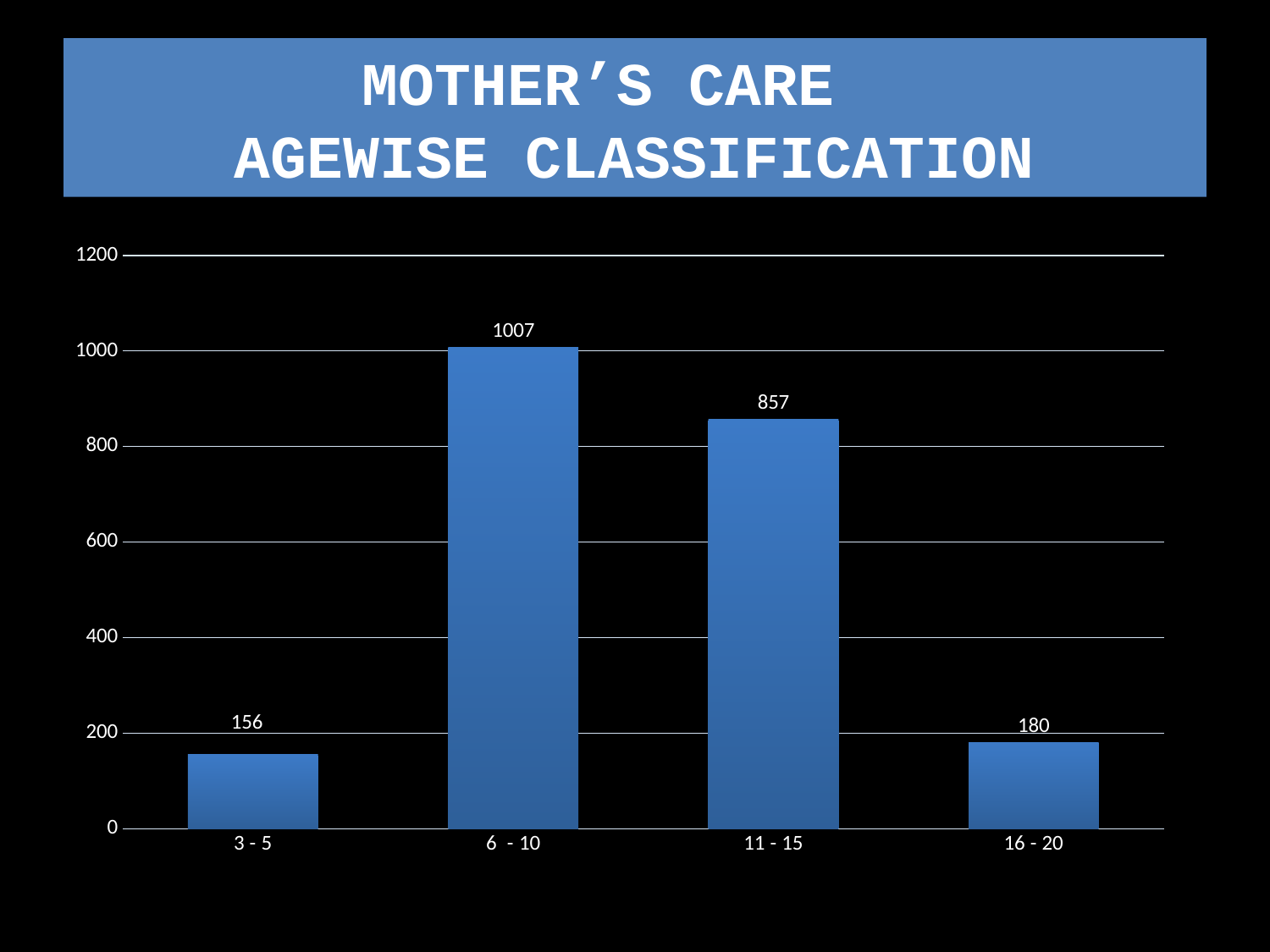
What is the value for the 16 - 20 age group? 180 How many age groups are shown on the chart? 4 Which age group has the highest value? 6 - 10 What is the value for the 6 - 10 age group? 1007 What is the difference between the values for the 6 - 10 and 11 - 15 age groups? 150 What is the value for the 11 - 15 age group? 857 What is the difference between the values for the 16 - 20 and 3 - 5 age groups? 24 What kind of chart is shown on the slide? bar chart What is the value for the 3 - 5 age group? 156 Is the value for the 11 - 15 age group greater or less than 800? greater Which age group has the lowest value? 3 - 5 Which is larger, the value for 16 - 20 or the value for 3 - 5? 16 - 20